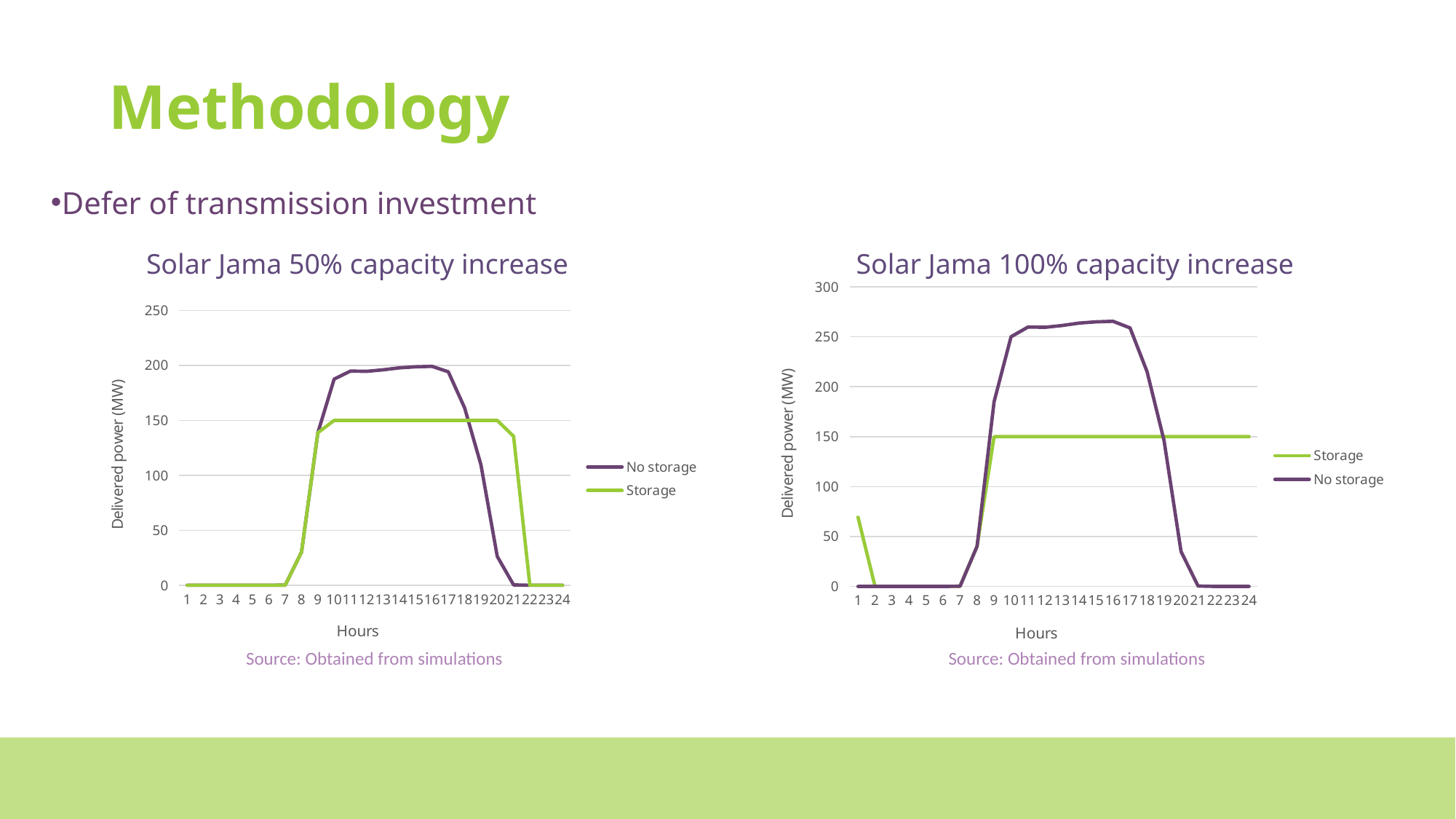
In the 'Solar Jama 100% capacity increase' chart, what is the Storage value at hour 20? 150 What type of chart is the 'Solar Jama 50% capacity increase' chart? line chart In the 'Solar Jama 100% capacity increase' chart, which series has the larger value at hour 22, Storage or No storage? Storage In the 'Solar Jama 50% capacity increase' chart, is the No storage value at hour 20 greater or less than 50? less In the 'Solar Jama 50% capacity increase' chart, what is the Storage value at hour 12? 150 In the 'Solar Jama 100% capacity increase' chart, is the No storage value at hour 16 greater or less than 250? greater How many hours are plotted along the x axis of the 'Solar Jama 100% capacity increase' chart? 24 In the 'Solar Jama 50% capacity increase' chart, which series has the larger value at hour 14, No storage or Storage? No storage In the 'Solar Jama 50% capacity increase' chart, what is the Storage value at hour 3? 0 What is the y-axis title of the 'Solar Jama 100% capacity increase' chart? Delivered power (MW) How many series does the legend of the 'Solar Jama 50% capacity increase' chart list? 2 In the 'Solar Jama 50% capacity increase' chart, is the No storage value at hour 15 greater or less than 150? greater